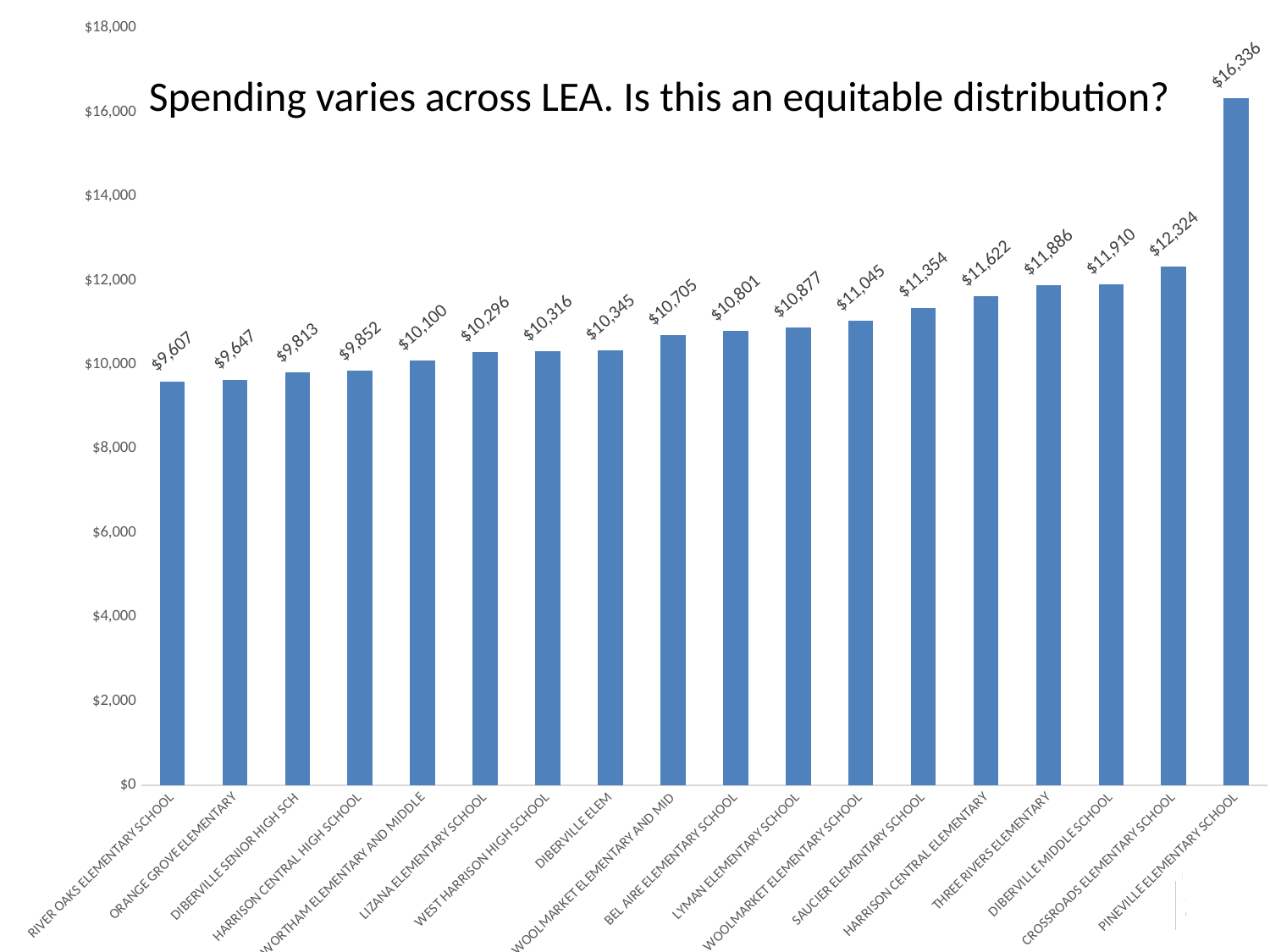
What is the difference between Crossroads Elementary School and Diberville Middle School? $414 What is the value for Saucier Elementary School? $11,354 What is the value for Pineville Elementary School? $16,336 What is the title of the chart? Spending varies across LEA. Is this an equitable distribution? Which school has the lowest spending? River Oaks Elementary School What is the difference between Pineville Elementary School and River Oaks Elementary School? $6,729 Which is larger, the value for Harrison Central Elementary or the value for Bel Aire Elementary School? Harrison Central Elementary Which school has the highest spending? Pineville Elementary School How many schools are shown on the chart? 18 What is the value for Lizana Elementary School? $10,296 Is the value for Three Rivers Elementary greater or less than $10,000? greater What kind of chart is shown on the slide? bar chart